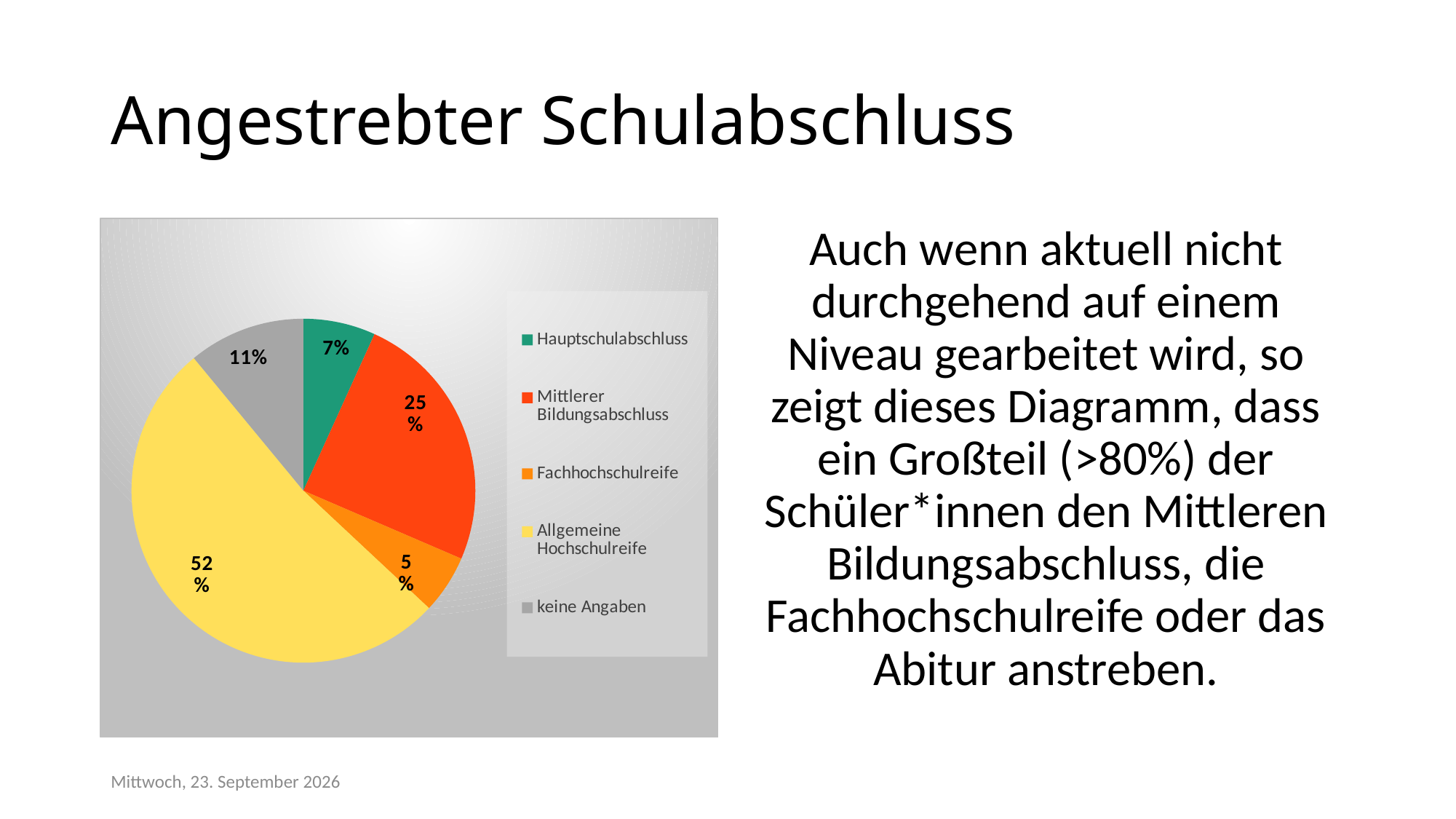
What is the value shown for Mittlerer Bildungsabschluss? 25% What kind of chart is shown on the slide? pie chart How many slices does the pie chart have? 5 Which category has the smallest slice of the pie? Fachhochschulreife What is the value shown for keine Angaben? 11% Which is larger, the value for keine Angaben or the value for Hauptschulabschluss? keine Angaben What share of the pie does Allgemeine Hochschulreife have? 52% What is the value shown for Hauptschulabschluss? 7% Which category has the largest slice of the pie? Allgemeine Hochschulreife What is the value shown for Fachhochschulreife? 5% Which colour is used for the Mittlerer Bildungsabschluss slice? red-orange What is the difference between the values for Allgemeine Hochschulreife and Mittlerer Bildungsabschluss? 27%